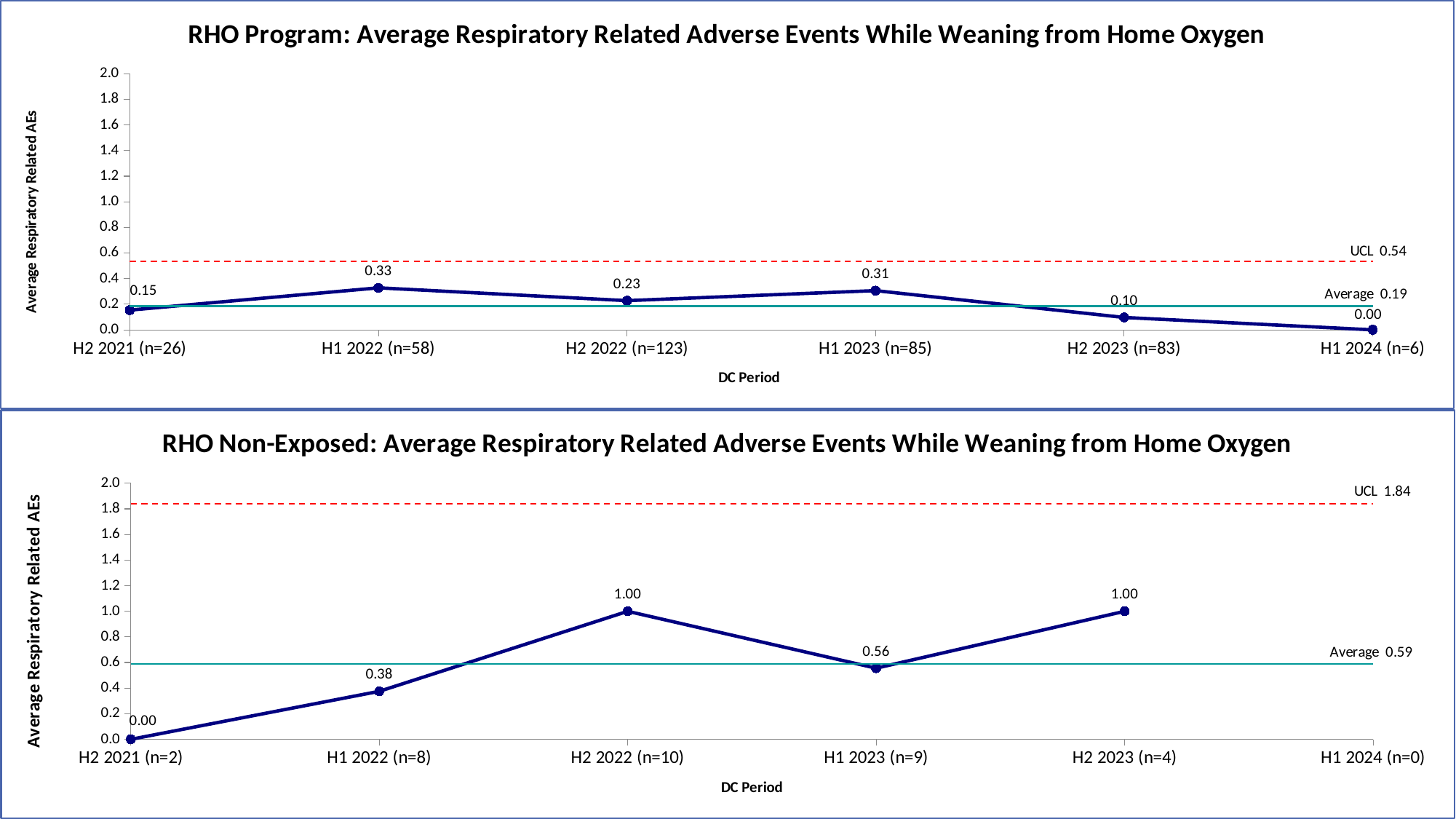
What kind of chart is the RHO Program chart (top)? line chart In the RHO Program chart (top), what is the UCL value shown? 0.54 In the RHO Program chart (top), what is the average respiratory related AEs value for H1 2022 (n=58)? 0.33 In the RHO Program chart (top), which DC period has the lowest value? H1 2024 (n=6) In the RHO Non-Exposed chart (bottom), what is the Average value shown? 0.59 In the RHO Program chart (top), how many DC periods are plotted on the x axis? 6 In the RHO Non-Exposed chart (bottom), what is the value for H1 2023 (n=9)? 0.56 In the RHO Non-Exposed chart (bottom), which is larger, the value for H1 2022 (n=8) or the value for H2 2022 (n=10)? H2 2022 (n=10) In the RHO Program chart (top), what is the difference between the values for H1 2023 (n=85) and H2 2023 (n=83)? 0.21 In the RHO Non-Exposed chart (bottom), what is the difference between the values for H2 2022 (n=10) and H1 2022 (n=8)? 0.62 In the RHO Program chart (top), which DC period has the highest value? H1 2022 (n=58) In the RHO Non-Exposed chart (bottom), do the values rise or fall from H2 2021 (n=2) to H2 2022 (n=10)? rise